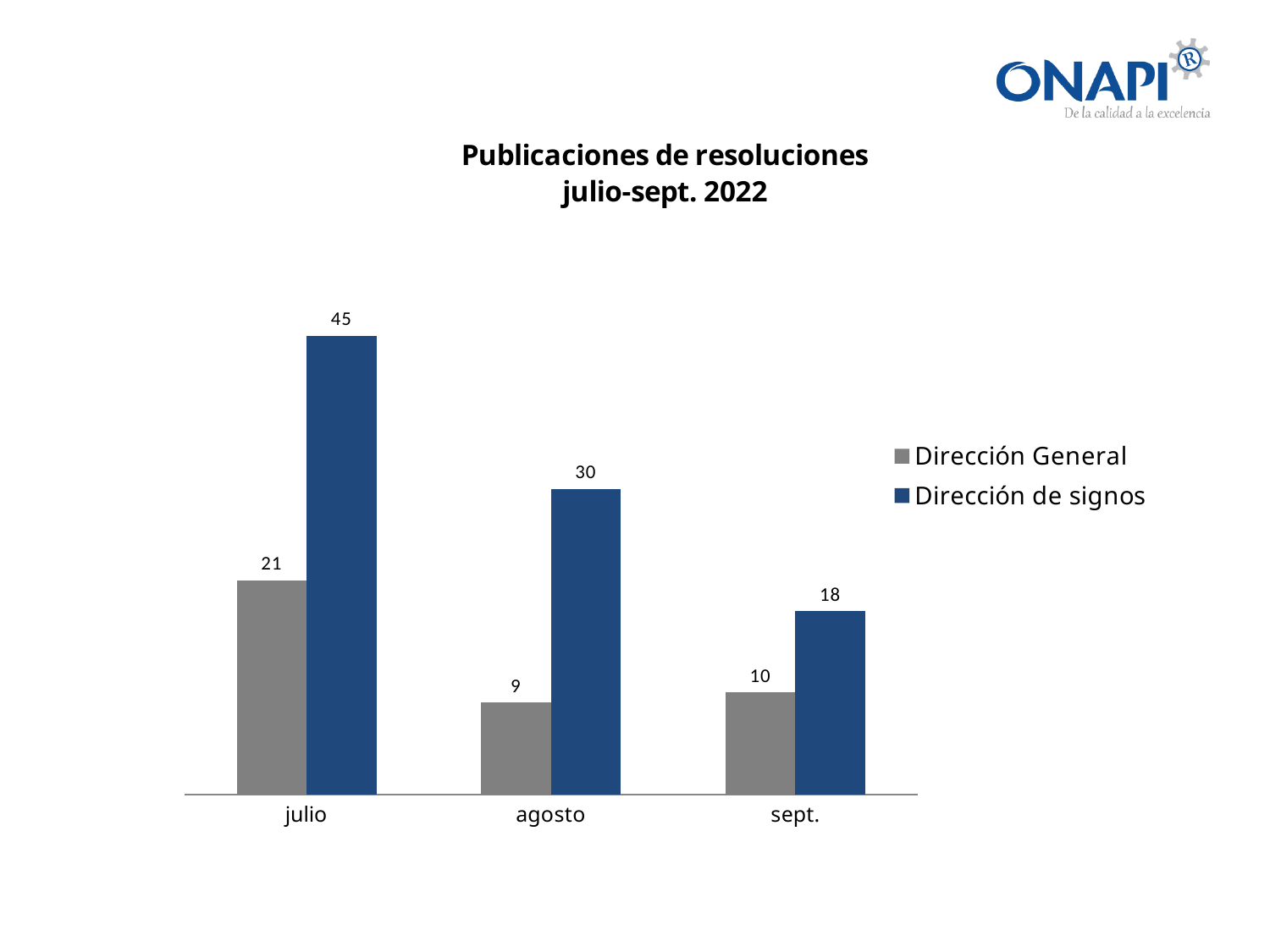
Which month has the lowest value for Dirección General? agosto How many months are shown on the x axis? 3 Which is larger in sept., Dirección General or Dirección de signos? Dirección de signos What is the value for Dirección General in agosto? 9 What is the difference between Dirección de signos and Dirección General in julio? 24 What is the value for Dirección de signos in sept.? 18 Which month has the highest value for Dirección de signos? julio What is the value for Dirección de signos in julio? 45 Do the values for Dirección de signos rise or fall from julio to sept.? fall How many series does the legend list? 2 What is the difference between Dirección de signos in agosto and in sept.? 12 What kind of chart is shown? bar chart